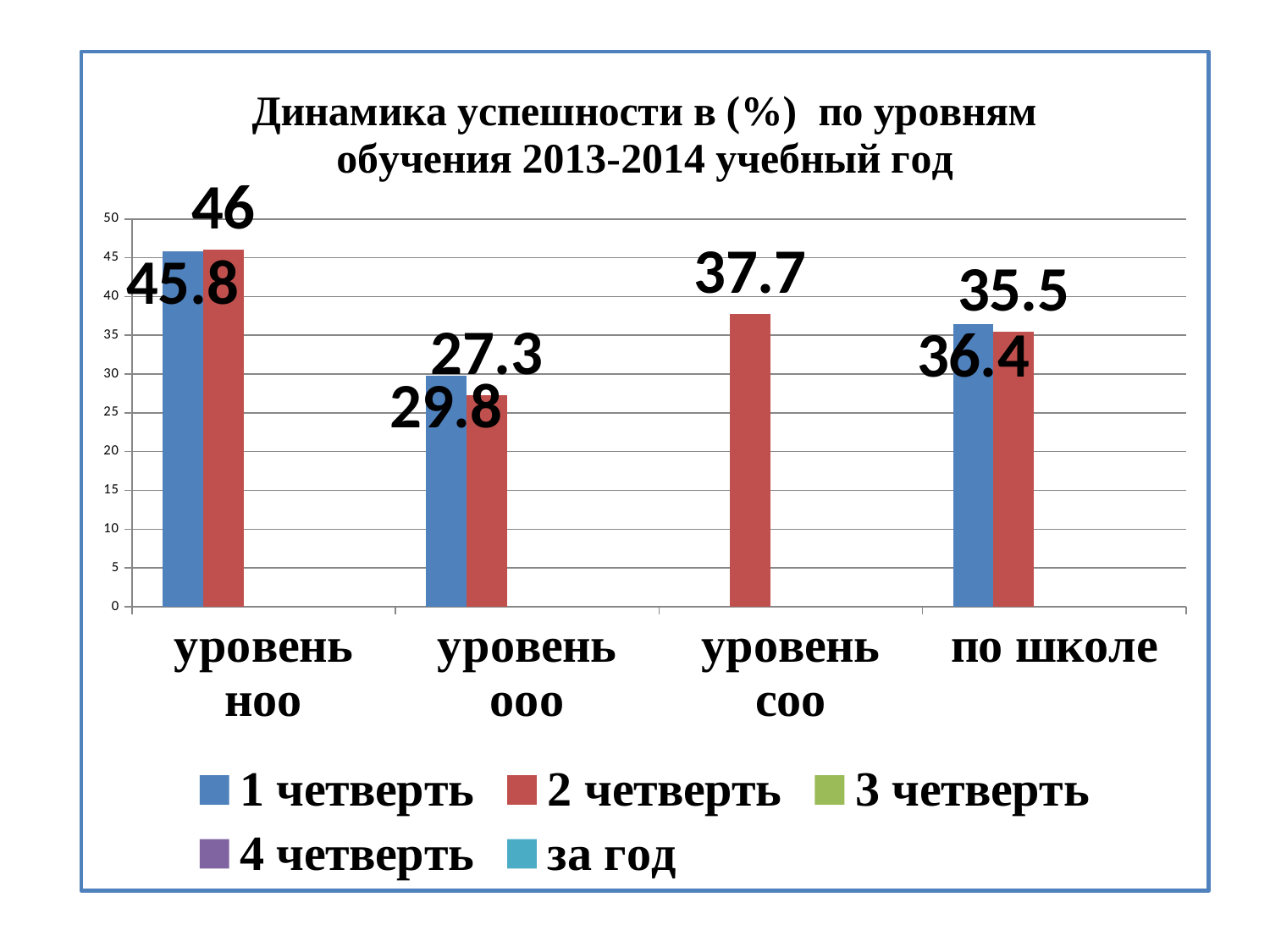
What is the difference between the 1 четверть values for уровень ноо and уровень ооо? 16 How many series does the legend list? 5 What kind of chart is shown on the slide? bar chart What is the value for 2 четверть at уровень ооо? 27.3 What is the value for 1 четверть at уровень ноо? 45.8 What is the value for 2 четверть at уровень соо? 37.7 Which category has the lowest value for 2 четверть? уровень ооо What is the difference between the 2 четверть values for уровень ноо and уровень соо? 8.3 What is the value for 1 четверть at по школе? 36.4 How many categories are shown on the x axis? 4 At уровень ооо, which is larger: 1 четверть or 2 четверть? 1 четверть Which category has the highest value for 2 четверть? уровень ноо